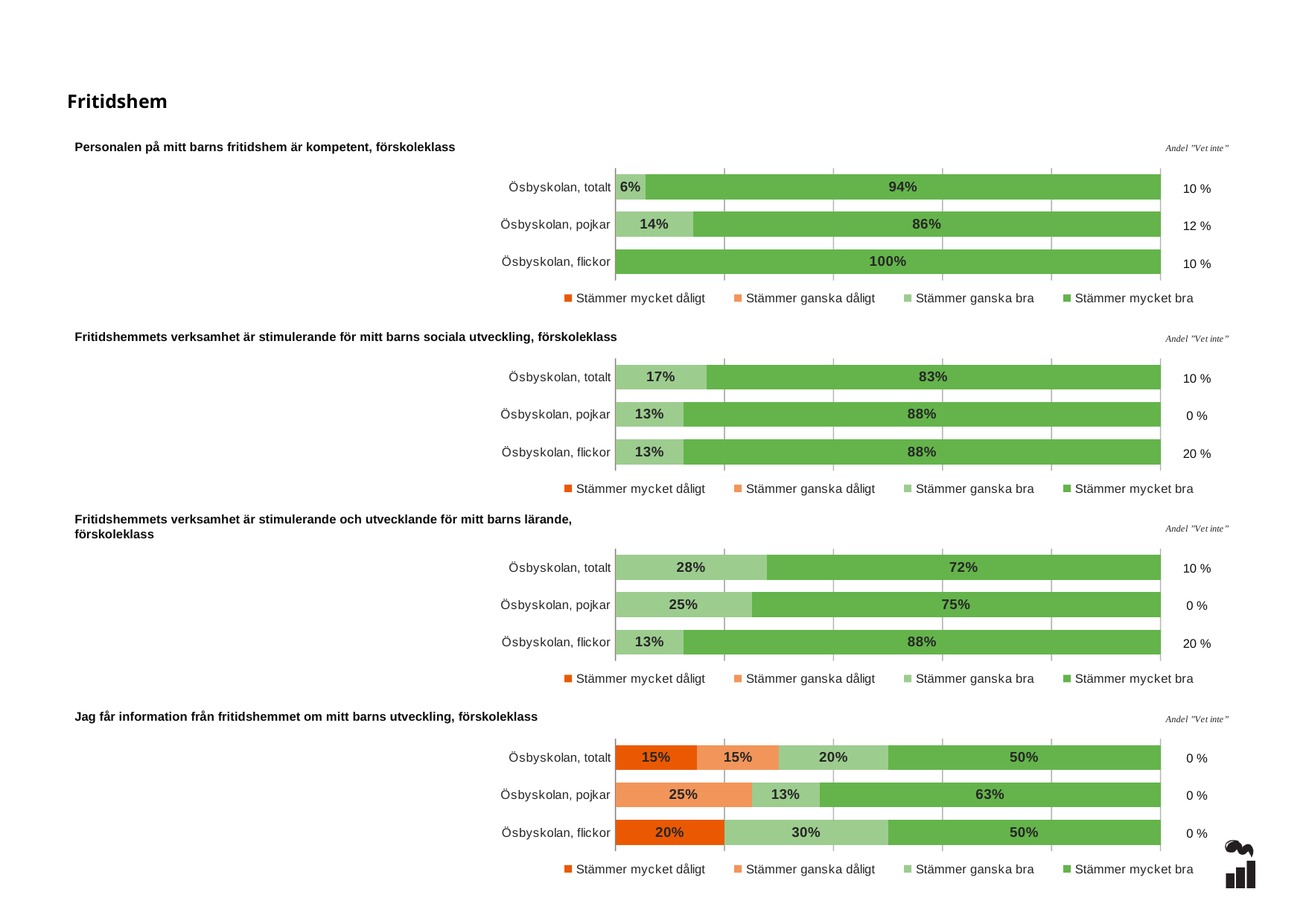
In the chart 'Personalen på mitt barns fritidshem är kompetent, förskoleklass', what is the 'Stämmer mycket bra' value for Ösbyskolan, totalt? 94% How many series does the legend list in the chart 'Jag får information från fritidshemmet om mitt barns utveckling, förskoleklass'? 4 In the chart 'Jag får information från fritidshemmet om mitt barns utveckling, förskoleklass', what is the total of the 'Stämmer ganska bra' and 'Stämmer mycket bra' segments for Ösbyskolan, totalt? 70% What kind of chart is 'Personalen på mitt barns fritidshem är kompetent, förskoleklass'? Stacked bar chart In the chart 'Fritidshemmets verksamhet är stimulerande för mitt barns sociala utveckling, förskoleklass', what is the 'Stämmer ganska bra' value for Ösbyskolan, totalt? 17% In the chart 'Personalen på mitt barns fritidshem är kompetent, förskoleklass', which category has the highest 'Stämmer mycket bra' value? Ösbyskolan, flickor In the chart 'Jag får information från fritidshemmet om mitt barns utveckling, förskoleklass', which is larger for Ösbyskolan, pojkar: 'Stämmer ganska dåligt' or 'Stämmer ganska bra'? Stämmer ganska dåligt In the chart 'Personalen på mitt barns fritidshem är kompetent, förskoleklass', what is the 'Stämmer ganska bra' value for Ösbyskolan, pojkar? 14% In the chart 'Fritidshemmets verksamhet är stimulerande och utvecklande för mitt barns lärande, förskoleklass', what is the 'Stämmer mycket bra' value for Ösbyskolan, totalt? 72% In the chart 'Jag får information från fritidshemmet om mitt barns utveckling, förskoleklass', what is the 'Stämmer mycket dåligt' value for Ösbyskolan, flickor? 20% In the chart 'Fritidshemmets verksamhet är stimulerande och utvecklande för mitt barns lärande, förskoleklass', which category has the lowest 'Stämmer ganska bra' value? Ösbyskolan, flickor In the chart 'Fritidshemmets verksamhet är stimulerande för mitt barns sociala utveckling, förskoleklass', what is the difference between the 'Stämmer mycket bra' values for Ösbyskolan, pojkar and Ösbyskolan, totalt? 5%